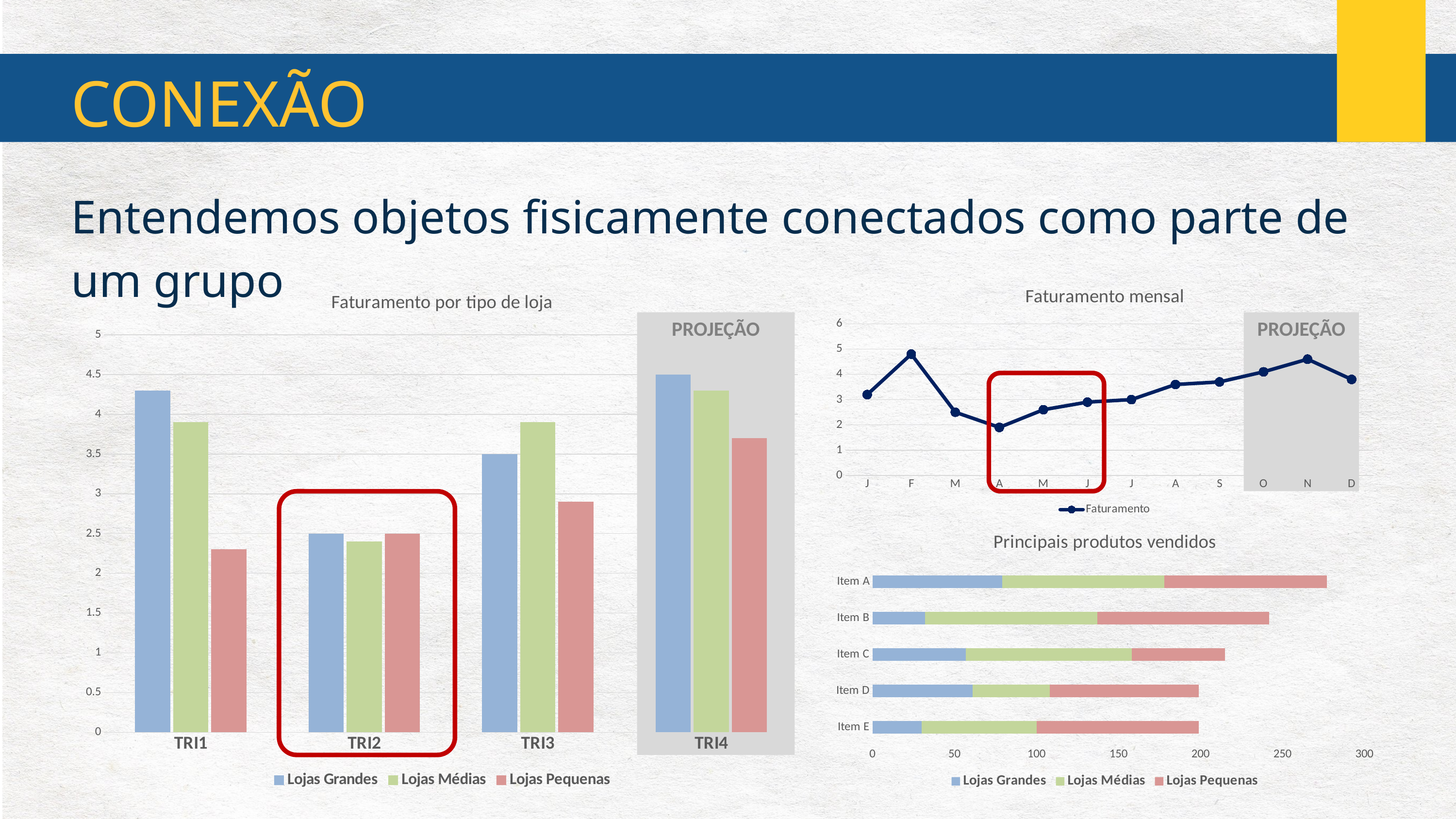
What kind of chart is "Principais produtos vendidos"? bar chart In "Faturamento por tipo de loja", which is larger for Lojas Grandes: TRI1 or TRI3? TRI1 In "Faturamento por tipo de loja", how many series does the legend list? 3 In "Faturamento mensal", which month has the lowest value? A In "Faturamento por tipo de loja", is the value for Lojas Médias in TRI2 greater or less than 3? less In "Faturamento mensal", which month has the highest value? F In "Faturamento por tipo de loja", how many quarters are shown on the x axis? 4 In "Faturamento mensal", do the values rise or fall from A to N? rise In "Faturamento por tipo de loja", is the value for Lojas Grandes in TRI1 greater or less than 4? greater In "Principais produtos vendidos", how many items are listed? 5 In "Principais produtos vendidos", which item has the longest total bar? Item A What kind of chart is "Faturamento mensal"? line chart